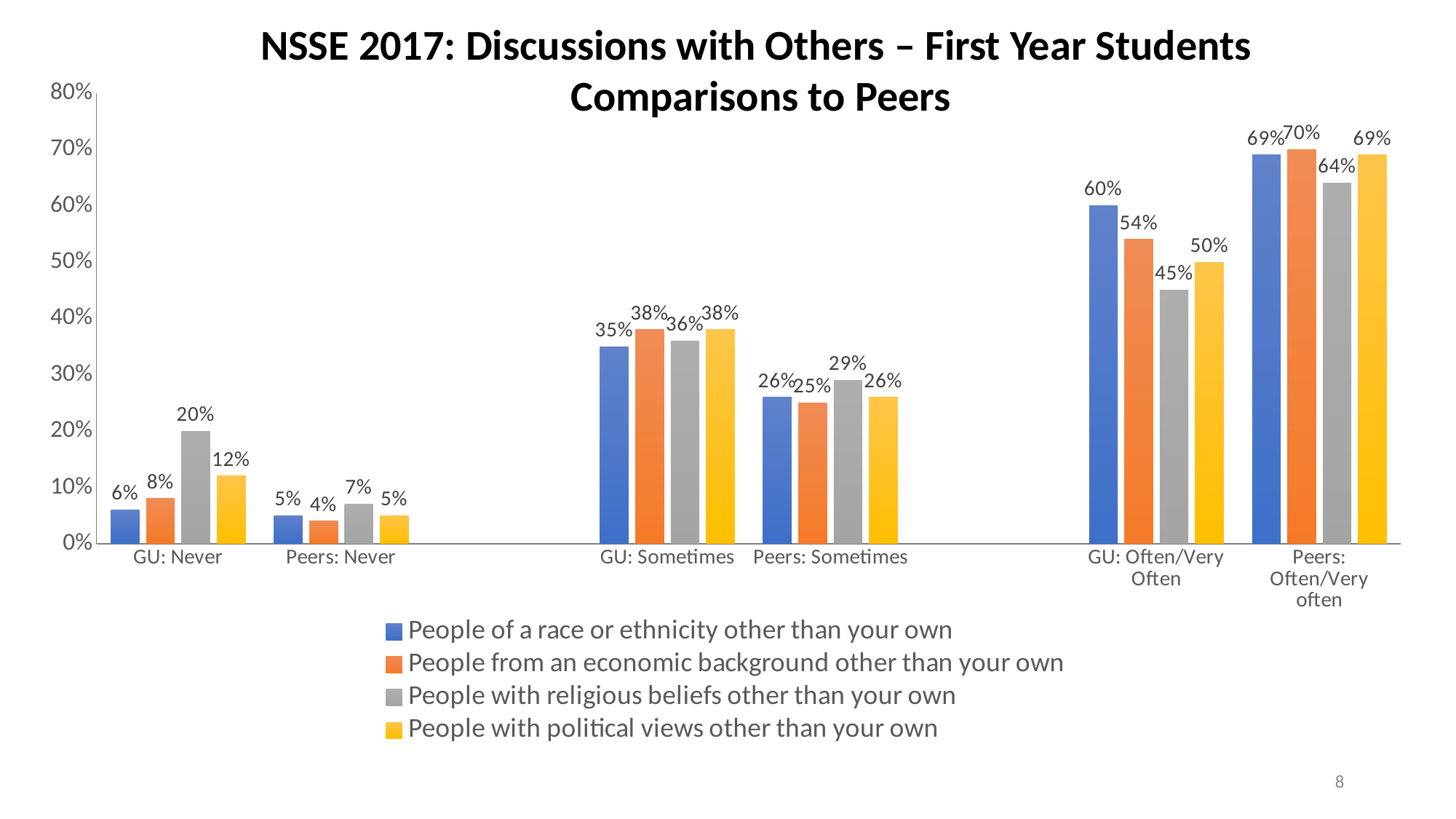
Which is larger: the 'People from an economic background other than your own' value for 'GU: Often/Very Often' or for 'Peers: Often/Very often'? Peers: Often/Very often What kind of chart is shown on the slide? Bar chart How many categories are shown on the x axis? 6 What is the title of the chart? NSSE 2017: Discussions with Others – First Year Students Comparisons to Peers Which series has the highest value in the 'Peers: Often/Very often' category? People from an economic background other than your own Is the value for 'People with political views other than your own' in 'GU: Often/Very Often' greater or less than 40%? greater What is the value for 'People with religious beliefs other than your own' in the 'GU: Never' category? 20% How many series does the legend list? 4 What is the value for 'People of a race or ethnicity other than your own' in the 'GU: Often/Very Often' category? 60% Which series has the lowest value in the 'GU: Often/Very Often' category? People with religious beliefs other than your own What is the difference between the 'People with religious beliefs other than your own' values for 'GU: Never' and 'Peers: Never'? 13% What is the value for 'People with political views other than your own' in the 'Peers: Sometimes' category? 26%